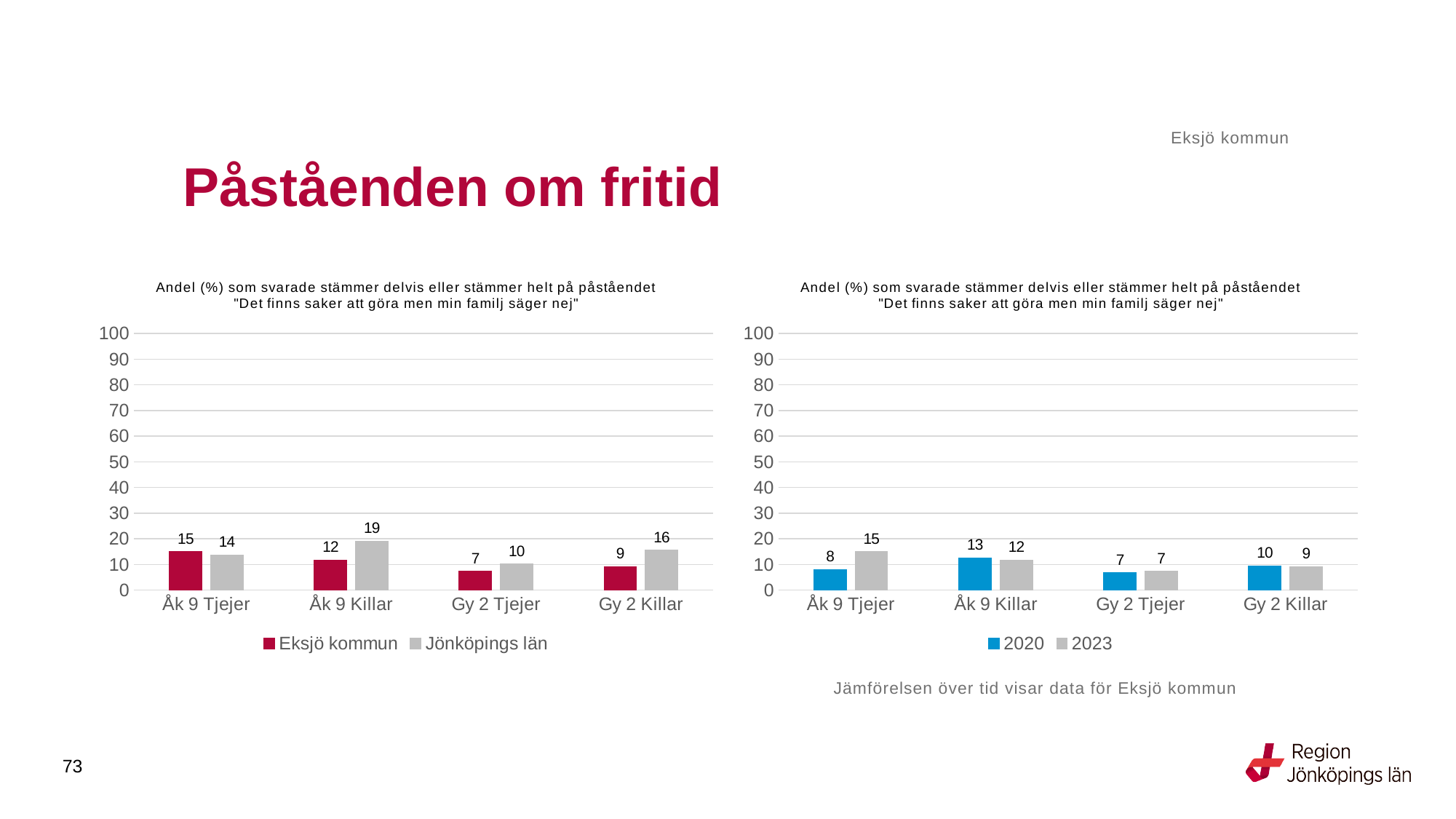
In the left chart, which category has the lowest value for Eksjö kommun? Gy 2 Tjejer In the left chart, what is the value for Jönköpings län for Åk 9 Killar? 19 In the right chart, what is the difference between the 2023 and 2020 values for Åk 9 Tjejer? 7 In the left chart, what is the difference between Jönköpings län and Eksjö kommun for Gy 2 Killar? 7 What type of chart is the right chart? Bar chart In the right chart, what is the 2023 value for Åk 9 Tjejer? 15 How many series does the legend of the left chart list? 2 In the left chart, what is the value for Eksjö kommun for Åk 9 Tjejer? 15 In the right chart, what is the 2020 value for Gy 2 Killar? 10 In the right chart, which is larger for Åk 9 Killar, the 2020 value or the 2023 value? 2020 In the left chart, which category has the highest value for Jönköpings län? Åk 9 Killar How many categories are shown on the x axis of the right chart? 4